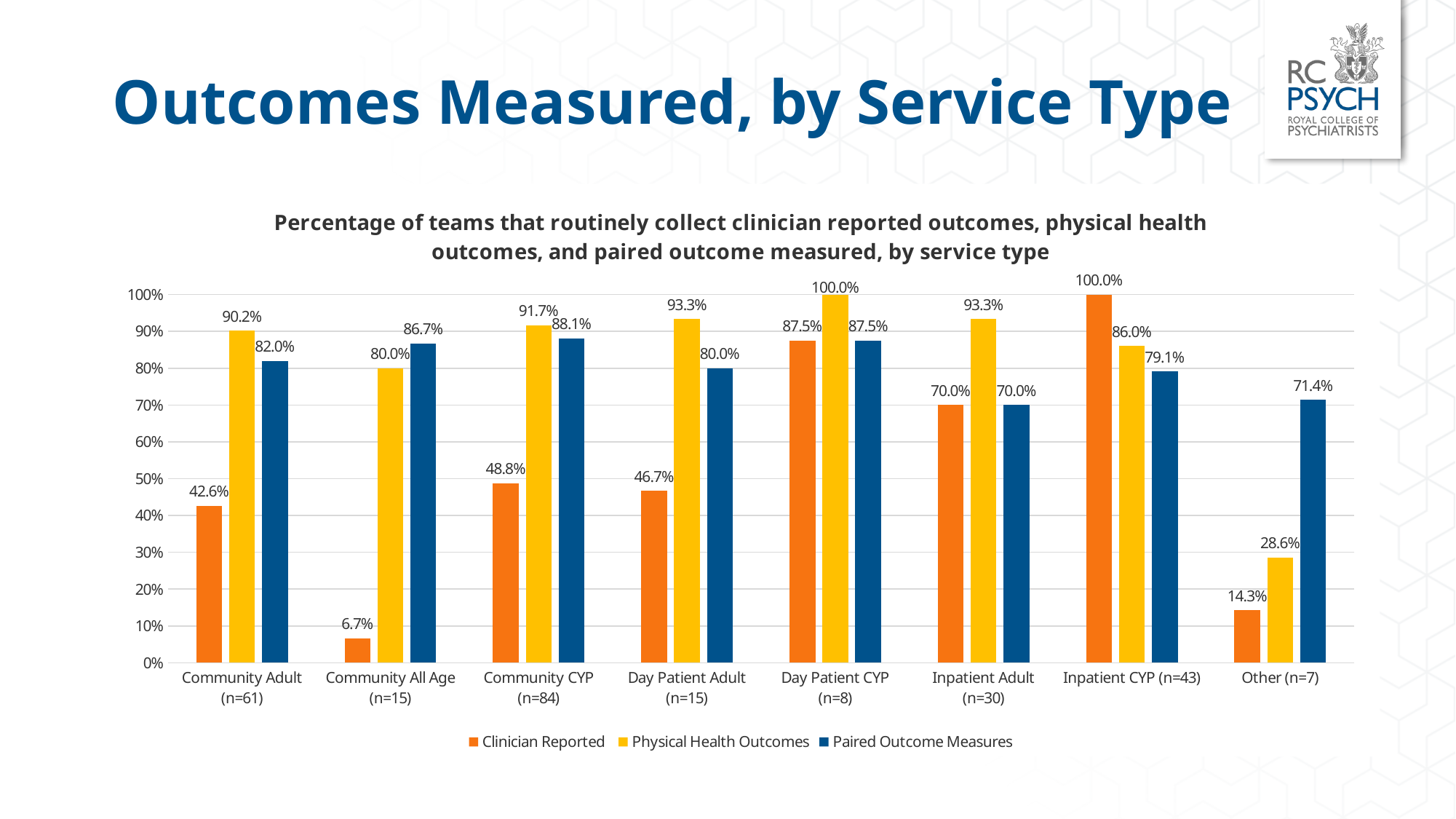
Which service type has the highest Clinician Reported value? Inpatient CYP (n=43) For Inpatient CYP (n=43), which is larger: the Physical Health Outcomes value or the Paired Outcome Measures value? Physical Health Outcomes How many service types are shown on the x axis? 8 Which service type has the lowest Physical Health Outcomes value? Other (n=7) What is the difference between the Physical Health Outcomes and Clinician Reported values for Community Adult (n=61)? 47.6% Which colour represents the Paired Outcome Measures series? Blue What is the Paired Outcome Measures value for Other (n=7)? 71.4% What is the Physical Health Outcomes value for Day Patient Adult (n=15)? 93.3% How many series does the legend list? 3 Which service type has the lowest Clinician Reported value? Community All Age (n=15) What is the Clinician Reported value for Community Adult (n=61)? 42.6% What kind of chart is shown on the slide? Bar chart